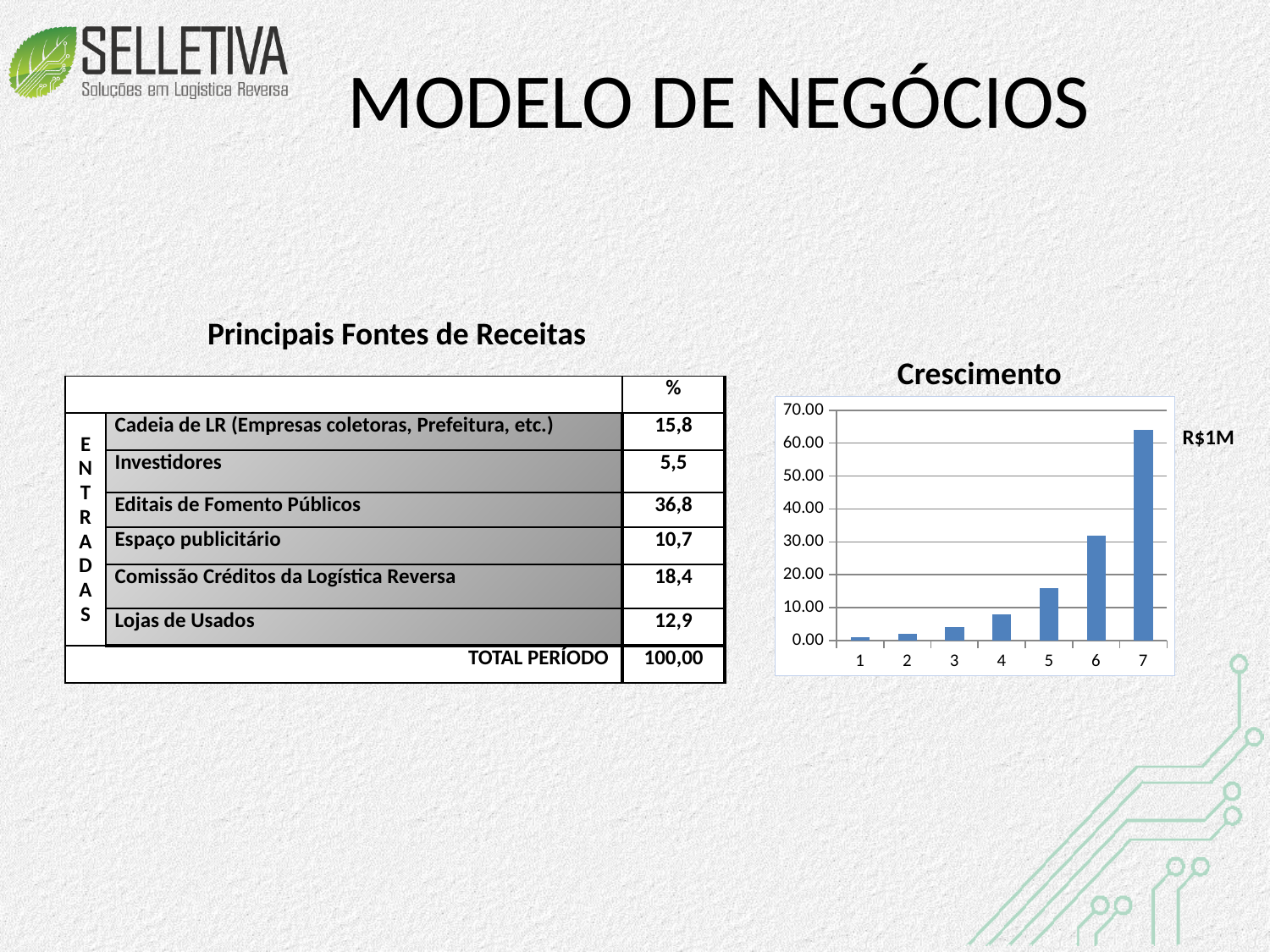
In the 'Crescimento' chart, is the value for category 7 greater or less than 60? greater What is the title of the chart on the slide? Crescimento In the 'Crescimento' chart, which category has the highest value? 7 In the 'Crescimento' chart, which category has the lowest value? 1 In the 'Crescimento' chart, is the value for category 5 greater or less than 20? less What type of chart is the 'Crescimento' chart? bar chart In the 'Crescimento' chart, is the value for category 6 greater or less than 20? greater How many bars are plotted in the 'Crescimento' chart? 7 What unit label is shown next to the tallest bar in the 'Crescimento' chart? R$1M In the 'Crescimento' chart, which is larger, the value for category 4 or category 5? 5 In the 'Crescimento' chart, do the values rise or fall from category 1 to category 7? rise